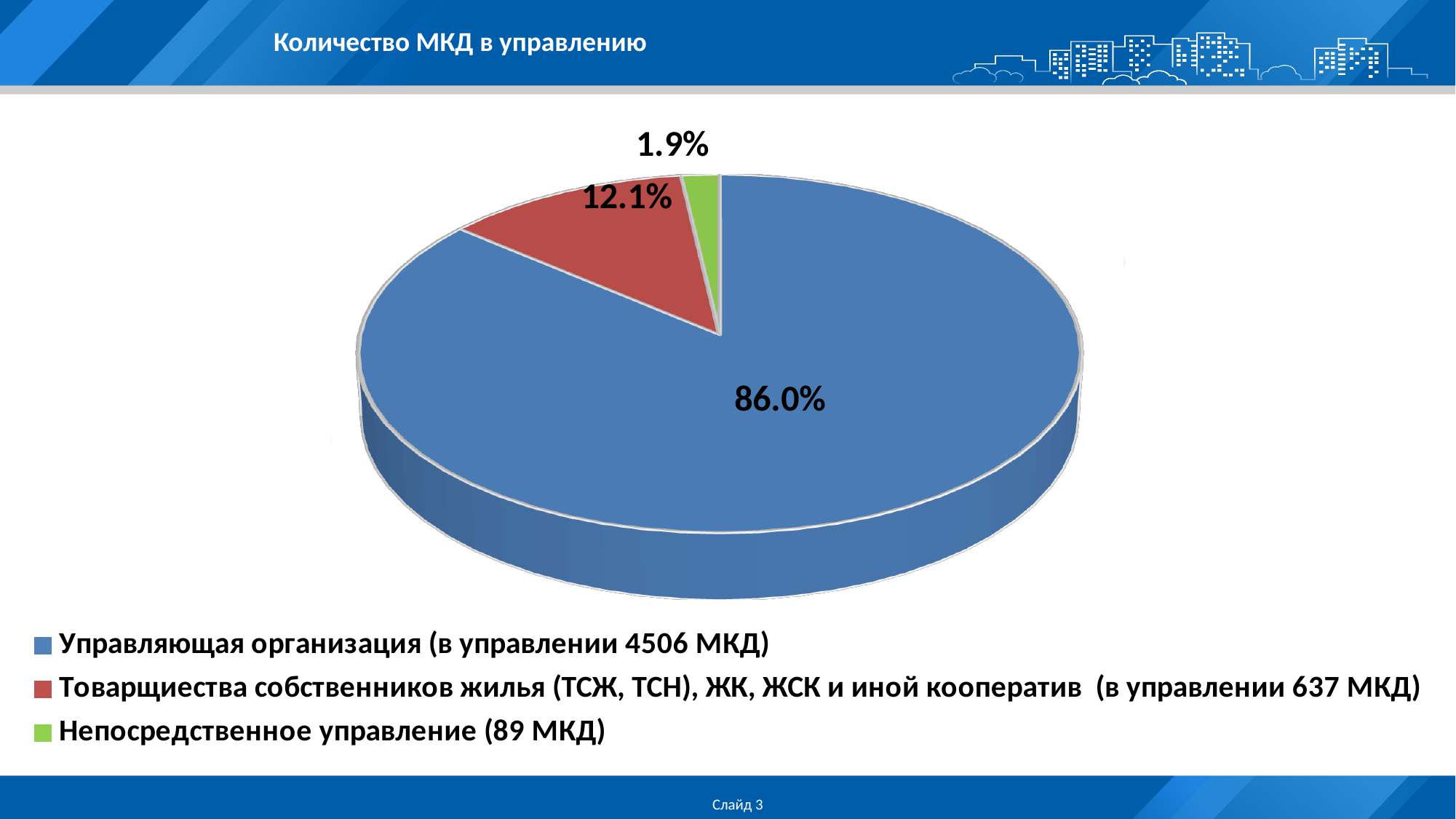
How many slices does the pie chart have? 3 What share of the pie does Непосредственное управление hold? 1.9% What is the title of the chart? Количество МКД в управлению What share of the pie does Управляющая организация hold? 86.0% What share of the pie does Товарищества собственников жилья (ТСЖ, ТСН), ЖК, ЖСК и иной кооператив hold? 12.1% According to the legend, how many МКД are managed by Управляющая организация? 4506 МКД Which category has the smallest slice of the pie? Непосредственное управление According to the legend, how many МКД are under Непосредственное управление? 89 МКД What is the difference in percentage points between the Управляющая организация slice and the Товарищества собственников жилья slice? 73.9% What kind of chart is shown on the slide? pie chart Which category has the largest slice of the pie? Управляющая организация Which slice is larger: Товарищества собственников жилья or Непосредственное управление? Товарищества собственников жилья